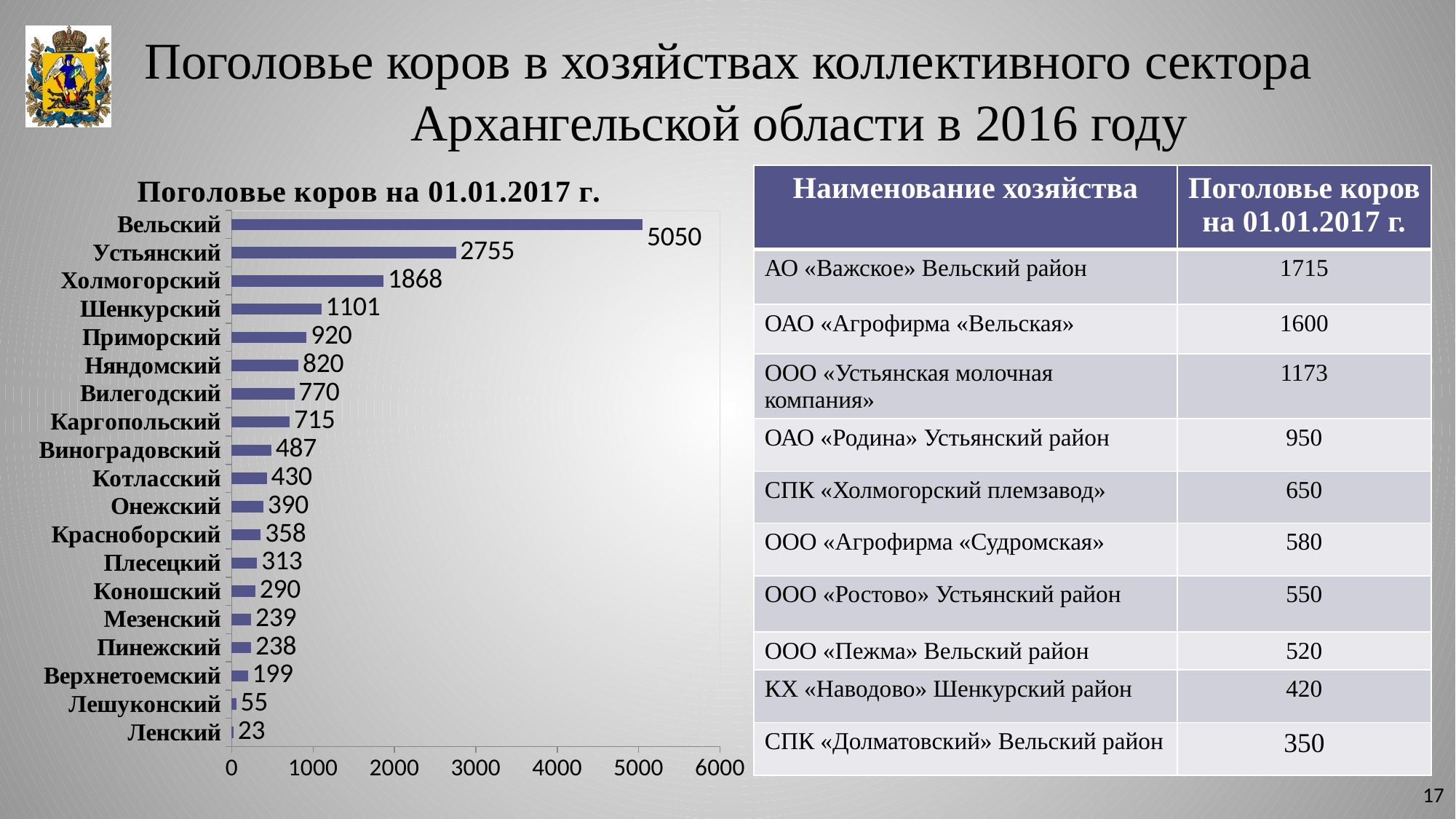
What is the title of the chart? Поголовье коров на 01.01.2017 г. How many categories are shown in the chart? 19 Which category has the highest value in the chart? Вельский Which is larger, the value for Няндомский or the value for Вилегодский? Няндомский What is the value for Приморский in the chart? 920 What is the value for Вельский in the chart? 5050 What is the value for Мезенский in the chart? 239 What is the highest tick value shown on the horizontal axis of the chart? 6000 What is the difference between the values for Устьянский and Холмогорский? 887 Is the value for Шенкурский greater or less than 1000? greater What kind of chart is shown on the slide? bar chart Which category has the lowest value in the chart? Ленский